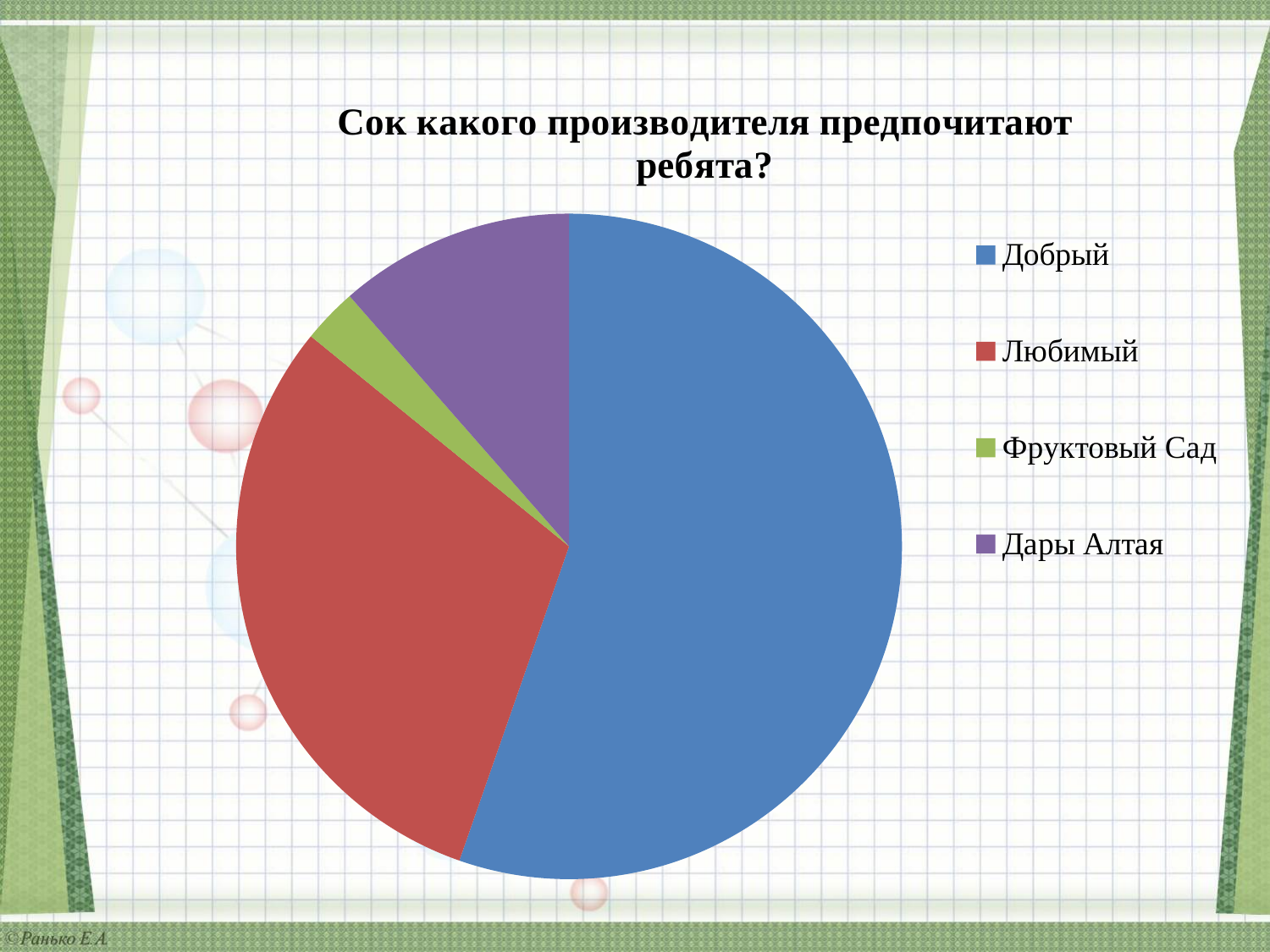
What colour is the slice for Добрый? Blue Which slice is larger, Дары Алтая or Фруктовый Сад? Дары Алтая Which juice producer has the largest slice of the pie? Добрый Which slice is larger, Любимый or Дары Алтая? Любимый Which juice producer has the smallest slice of the pie? Фруктовый Сад What is the title of the chart? Сок какого производителя предпочитают ребята? How many categories (slices) does the pie chart have? 4 What kind of chart is shown on the slide? Pie chart Which slice is larger, Добрый or Любимый? Добрый Which category is shown in red on the pie chart? Любимый